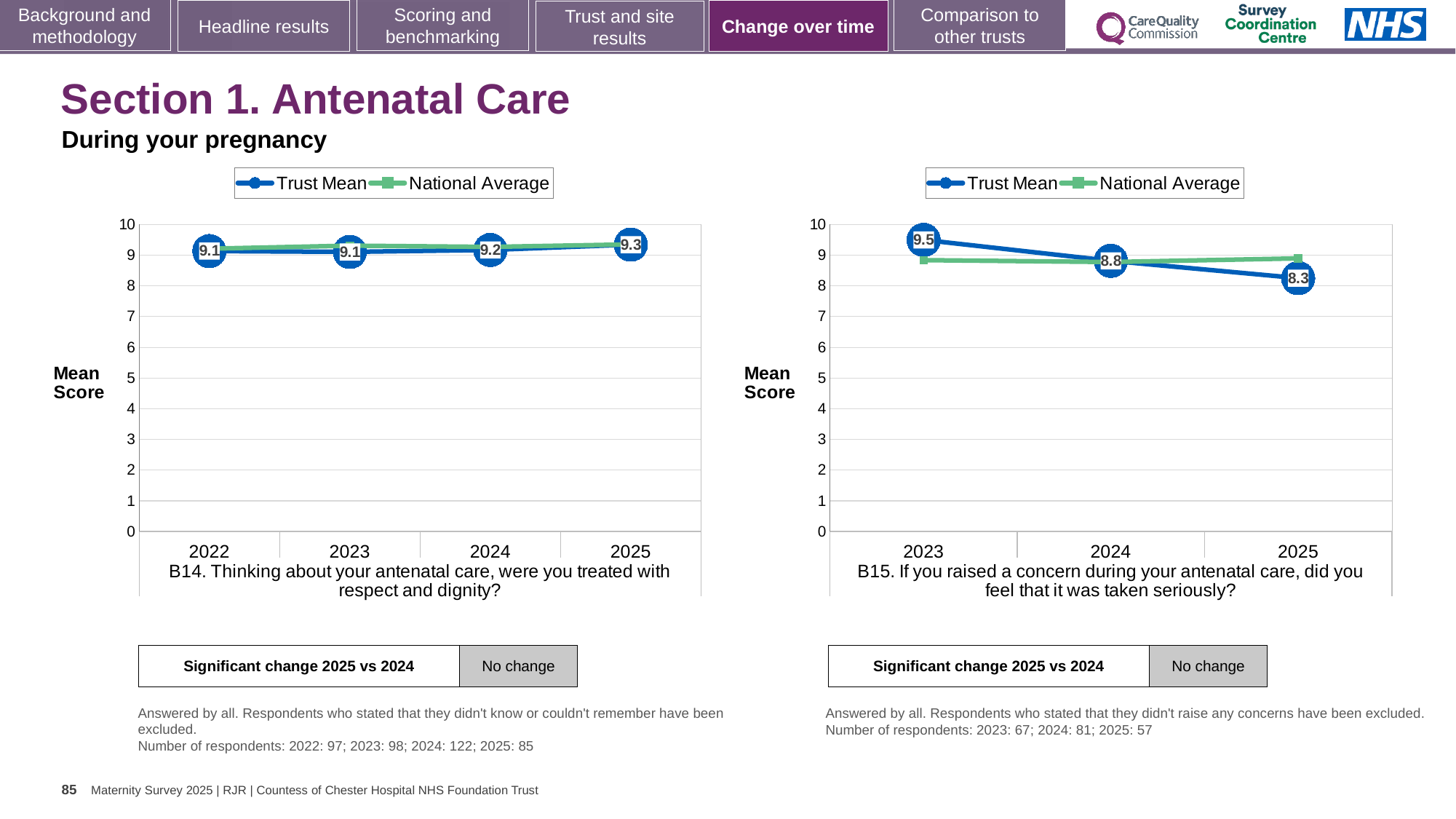
In the B15 chart (right), which year has the lowest Trust Mean? 2025 In the B14 chart (left), what is the Trust Mean for 2025? 9.3 In the B15 chart (right), what is the Trust Mean for 2025? 8.3 In the B15 chart (right), is the Trust Mean for 2024 greater or less than 9? less In the B15 chart (right), what is the Trust Mean for 2023? 9.5 How many series does the legend of the B15 chart (right) list? 2 In the B14 chart (left), what is the Trust Mean for 2022? 9.1 In the B14 chart (left), what is the difference between the Trust Mean for 2025 and 2022? 0.2 How many years are plotted on the x axis of the B14 chart (left)? 4 In the B15 chart (right), which year has the highest Trust Mean? 2023 In the B15 chart (right), what is the difference between the Trust Mean for 2023 and 2025? 1.2 In the B15 chart (right), does the Trust Mean rise or fall from 2023 to 2025? fall